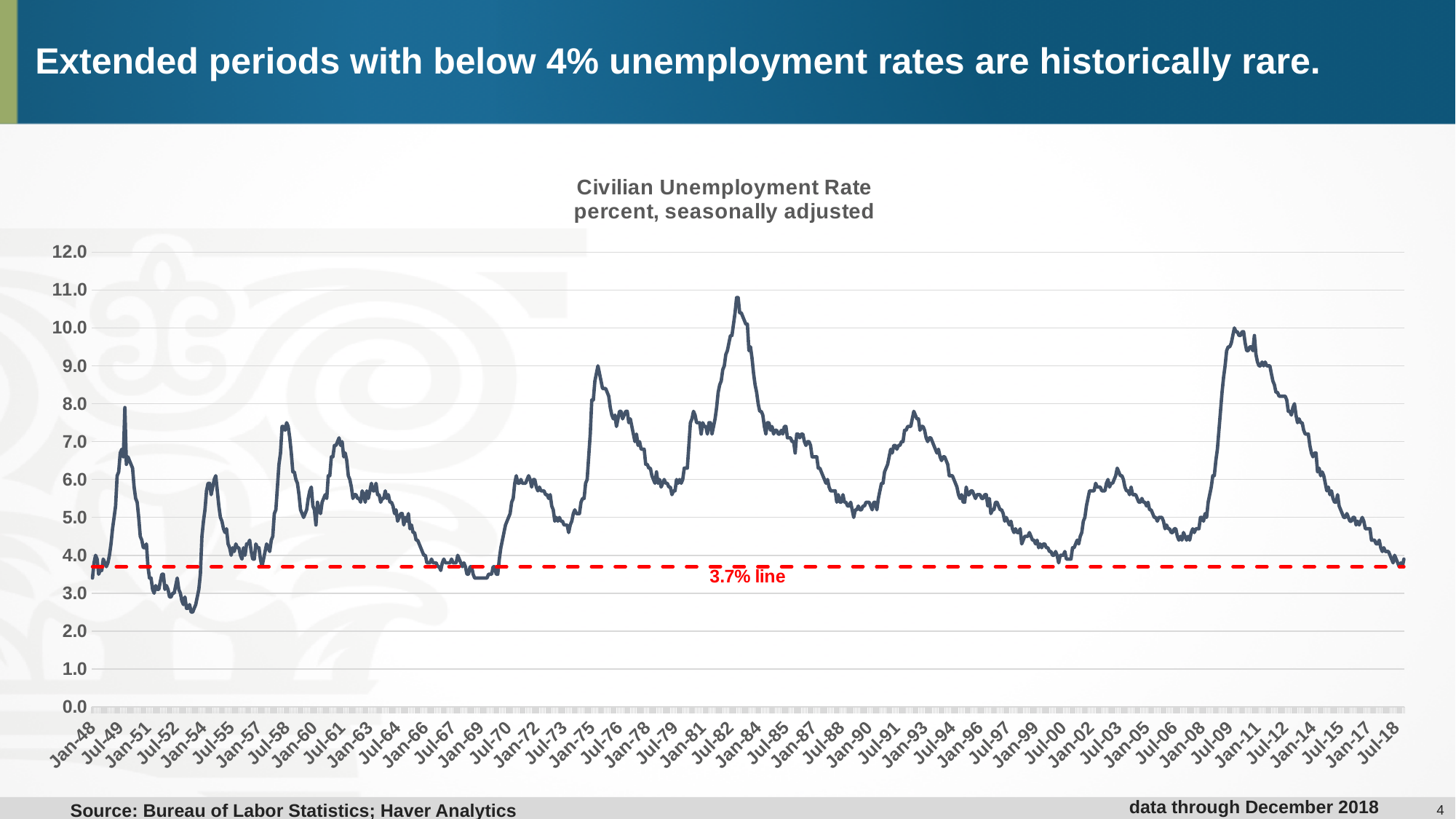
Is the unemployment rate at Jul-00 greater or less than 5.0? less Does the unemployment rate rise or fall from Jul-09 to Jul-18? fall Which trough is lower: the one around 1953 (between Jul-52 and Jan-54) or the one around 1969 (near Jan-69)? 1953 What is the title of the chart? Civilian Unemployment Rate What source is cited for the chart data? Bureau of Labor Statistics; Haver Analytics Is the peak of the unemployment rate near Jul-82 greater or less than 10.0? greater Is the unemployment rate at Jul-18 greater or less than 5.0? less What kind of chart is shown on the slide? line chart Which peak is higher: the one near Jul-82 or the one near Jul-09? Jul-82 What value does the red dashed horizontal line on the chart mark? 3.7%